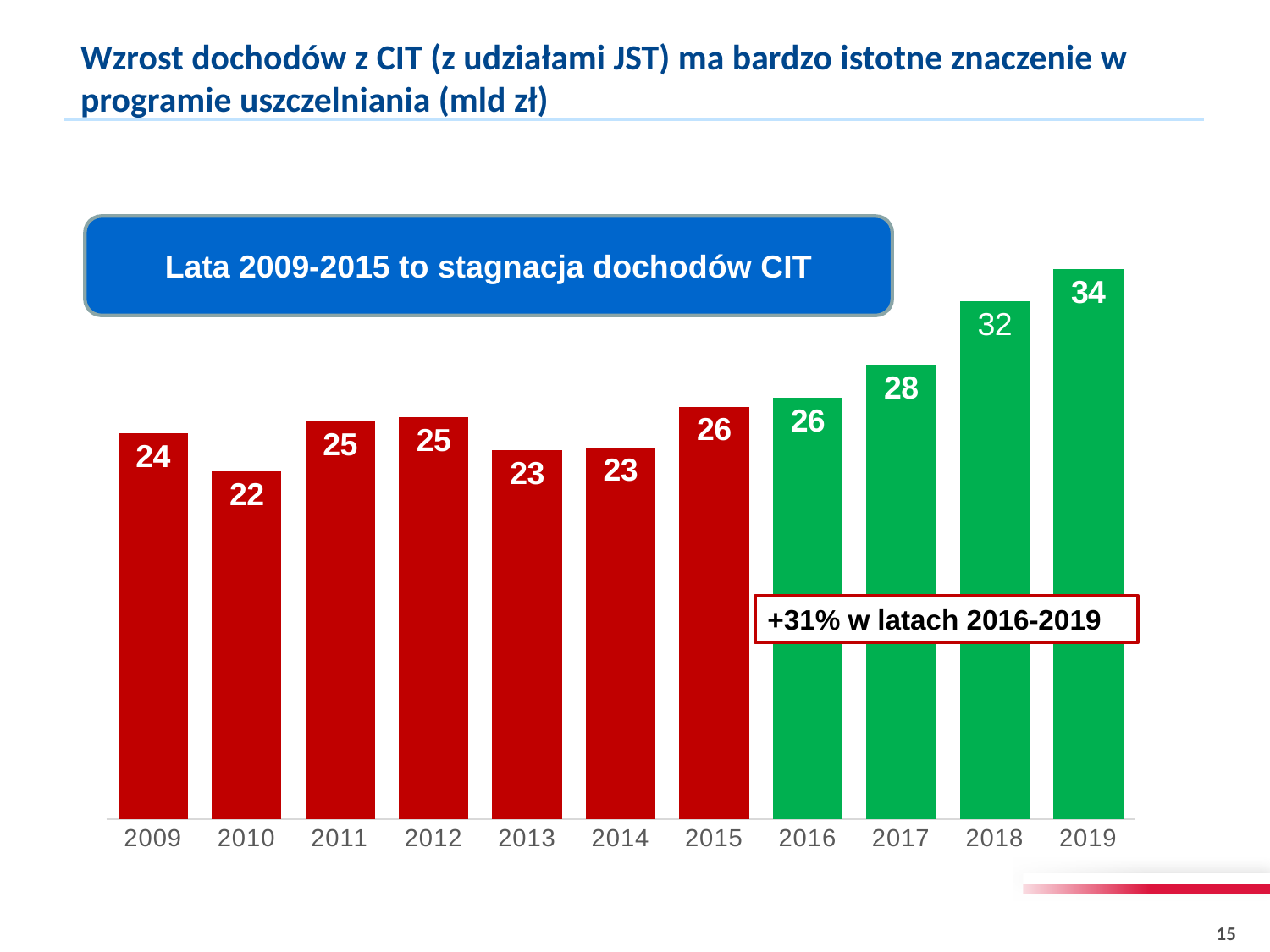
Which is larger, the value for 2017 or the value for 2011? 2017 Do the values rise or fall from 2016 to 2019? rise What is the value for 2009? 24 What is the value for 2019? 34 What kind of chart is shown on the slide? bar chart What colour are the bars for 2016 to 2019? green Which year has the lowest value? 2010 Which year has the highest value? 2019 How many years are shown on the x axis? 11 What percentage increase does the red box state for the years 2016-2019? +31% What is the value for 2016? 26 What is the difference between the values for 2019 and 2015? 8